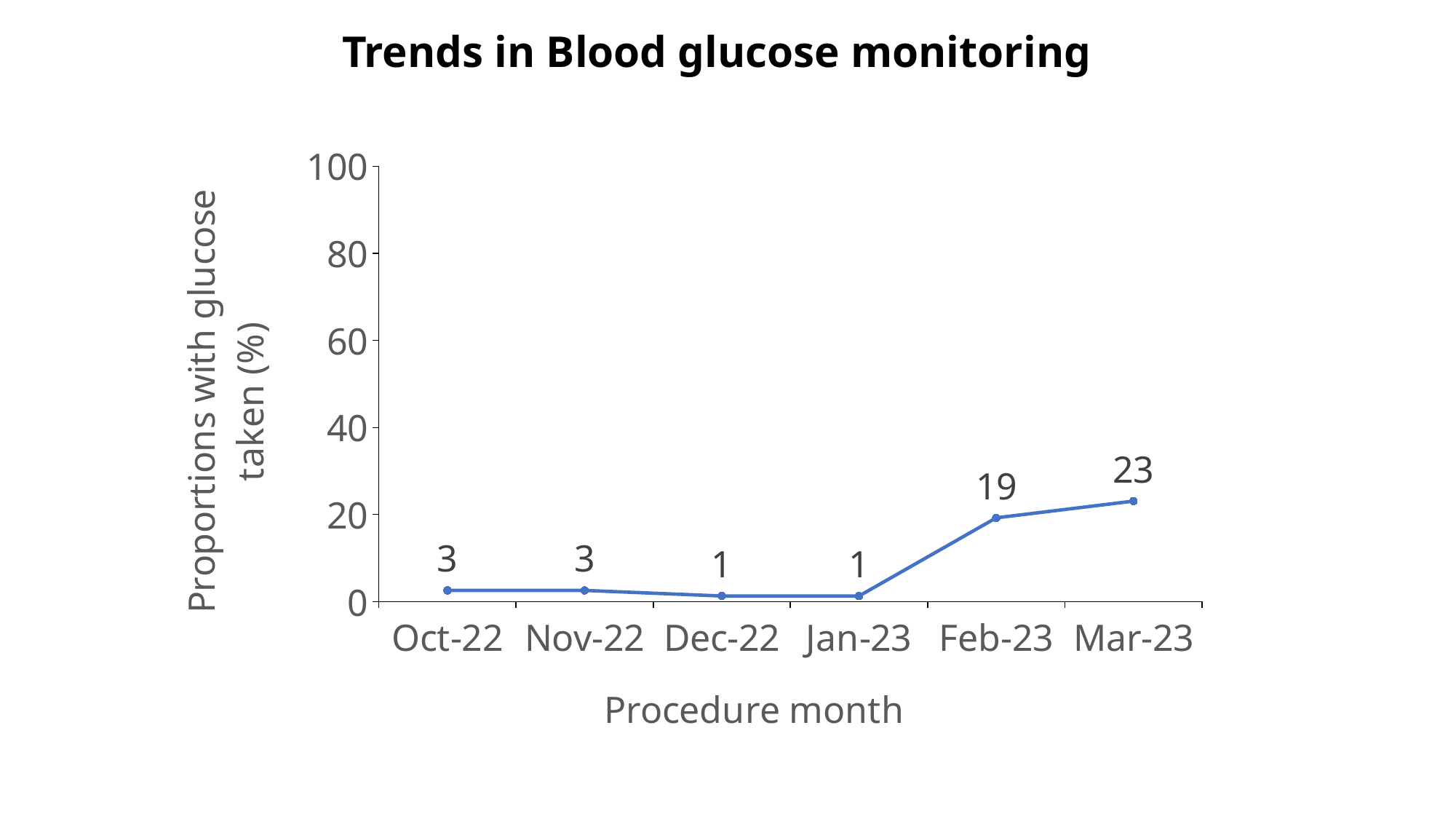
What is the value for Feb-23? 19 Which is larger, the value for Nov-22 or the value for Feb-23? Feb-23 How many months are plotted on the x axis? 6 What kind of chart is shown? line chart What is the difference between the values for Feb-23 and Jan-23? 18 Is the value for Mar-23 greater or less than 40? less What is the value for Dec-22? 1 What is the title of the chart? Trends in Blood glucose monitoring Do the values rise or fall from Jan-23 to Mar-23? rise Which month has the highest value? Mar-23 What is the value for Oct-22? 3 What is the difference between the values for Mar-23 and Feb-23? 4